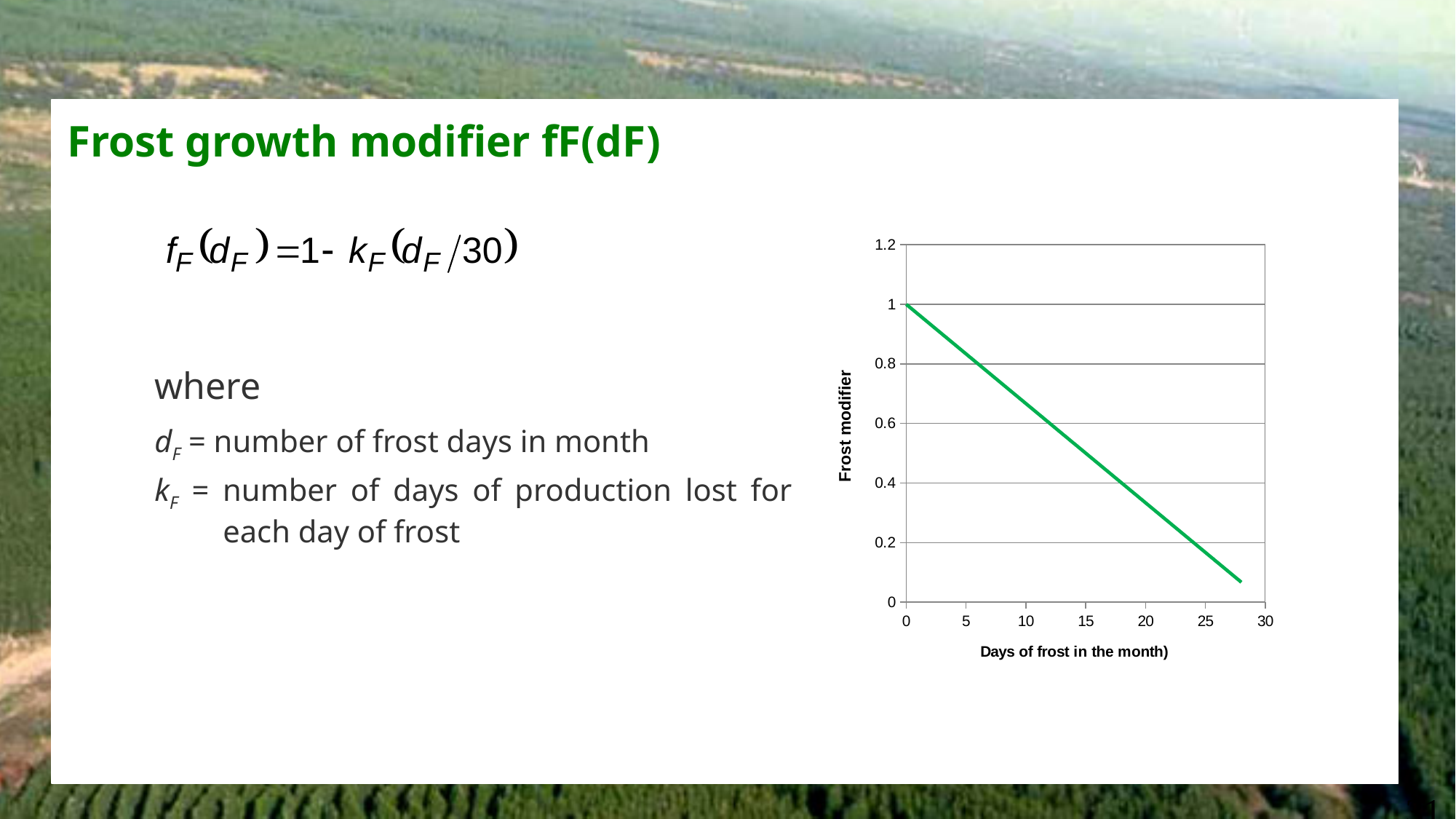
Does the frost modifier rise or fall as the days of frost in the month increase? fall Is the frost modifier at 15 days of frost greater or less than 0.6? less What is the frost modifier value when the number of days of frost is 0? 1 Which has the larger frost modifier: 5 days of frost or 25 days of frost? 5 days of frost Is the frost modifier at 20 days of frost greater or less than 0.4? less What is the highest value shown on the vertical axis of the chart? 1.2 Is the frost modifier at 15 days of frost greater or less than 0.4? greater What kind of chart is shown on the slide? line chart At which end of the x axis, 0 days or 28 days, is the frost modifier lowest? 28 days What is the label of the vertical axis of the chart? Frost modifier